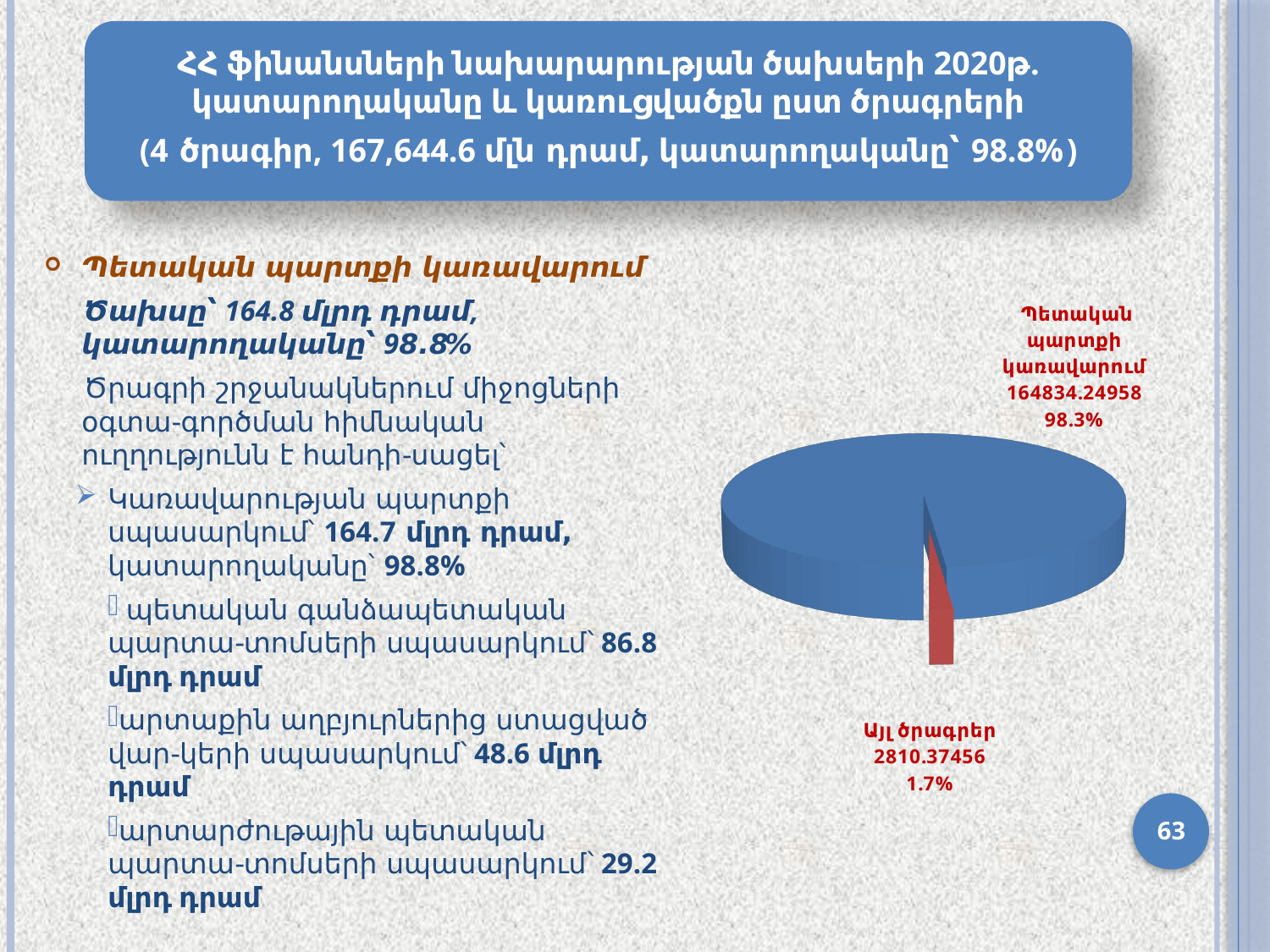
What value is shown for the slice labelled Այլ ծրագրեր? 2810.37456 Which is larger, the value for Պետական պարտքի կառավարում or the value for Այլ ծրագրեր? Պետական պարտքի կառավարում Which slice of the pie chart is the largest? Պետական պարտքի կառավարում What share of the pie does the Պետական պարտքի կառավարում slice represent? 98.3% What colour is the Այլ ծրագրեր slice in the pie chart? red What value is shown for the slice labelled Պետական պարտքի կառավարում? 164834.24958 What share of the pie does the Այլ ծրագրեր slice represent? 1.7% How many slices does the pie chart have? 2 Which slice of the pie chart is the smallest? Այլ ծրագրեր What is the difference in percentage share between the Պետական պարտքի կառավարում slice and the Այլ ծրագրեր slice? 96.6% What kind of chart is shown on the slide? pie chart What colour is the Պետական պարտքի կառավարում slice in the pie chart? blue